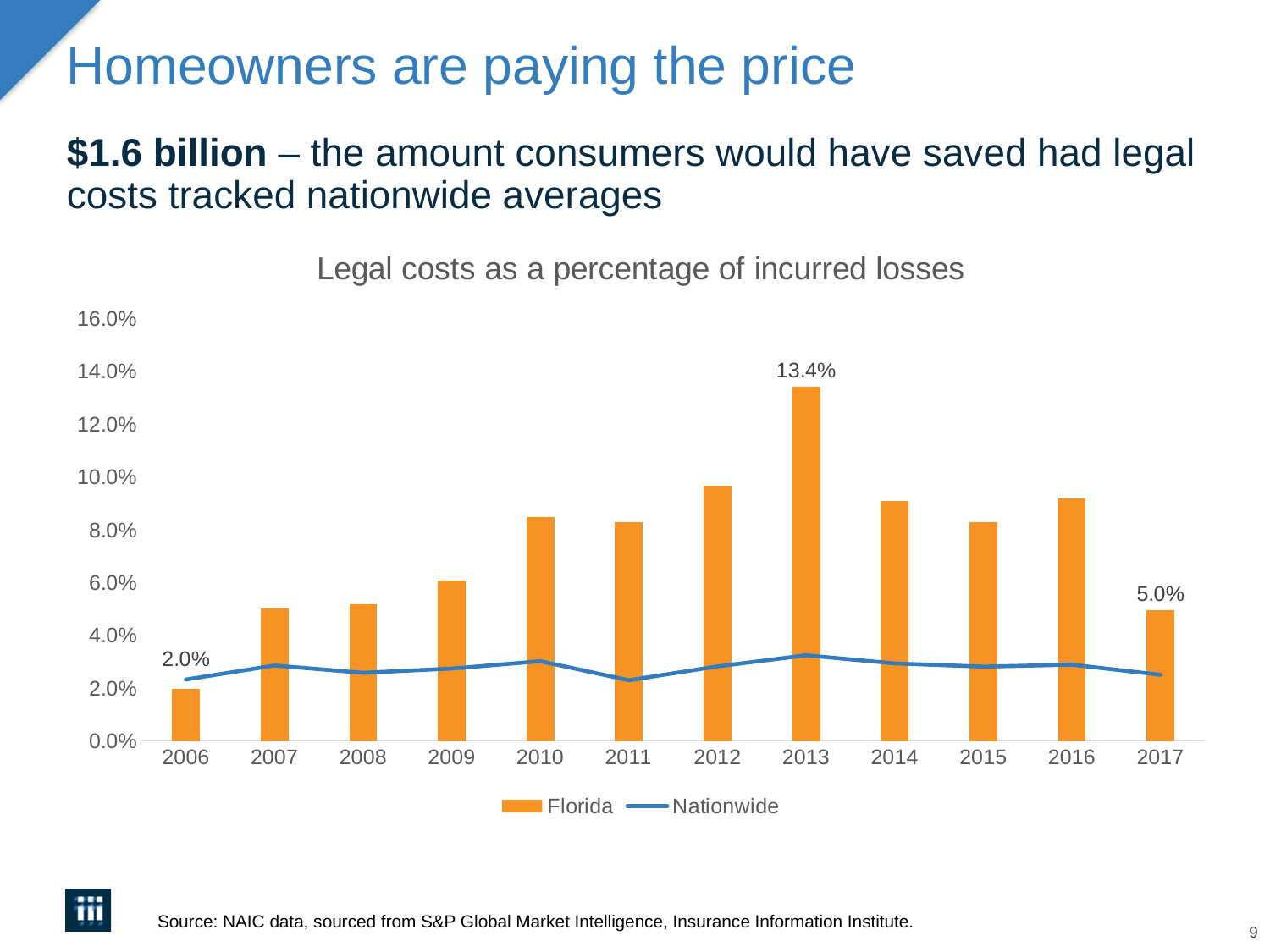
What is the value for Florida in 2013? 13.4% What is the difference between the Florida values for 2013 and 2006? 11.4% In which year is the Florida value highest? 2013 What is the title of the chart? Legal costs as a percentage of incurred losses Which year has the larger Florida value, 2010 or 2009? 2010 In which year is the Florida value lowest? 2006 What is the value for Florida in 2006? 2.0% How many series does the legend list? 2 What is the value for Florida in 2017? 5.0% Is the Florida value for 2009 greater or less than 8.0%? less How many years are shown on the x axis? 12 Is the Florida value for 2012 greater or less than 8.0%? greater